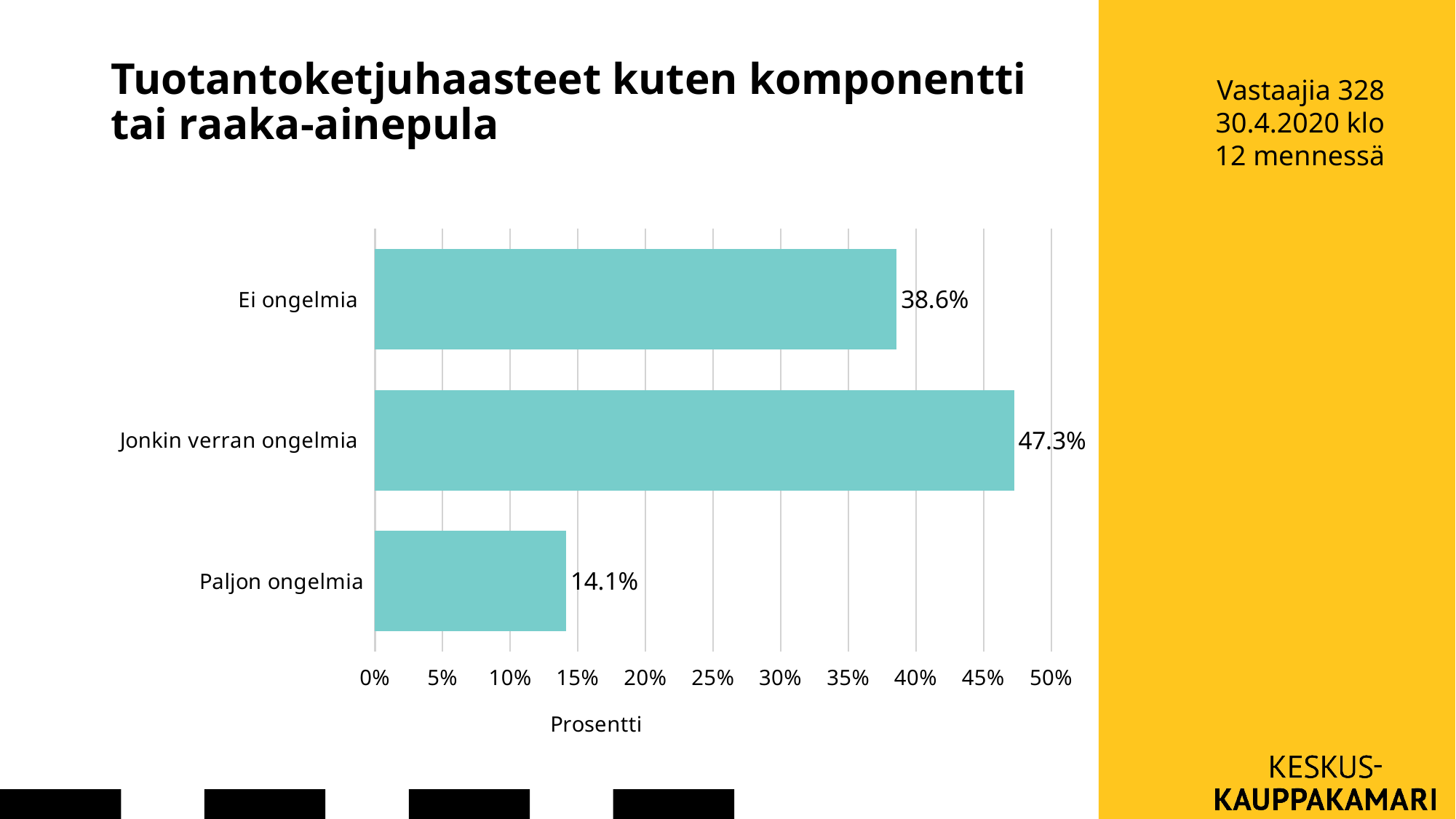
What is the difference between the values for "Jonkin verran ongelmia" and "Ei ongelmia"? 8.7% Which is larger, the value for "Ei ongelmia" or the value for "Paljon ongelmia"? Ei ongelmia Is the value for "Jonkin verran ongelmia" greater or less than 45%? greater What is the difference between the values for "Ei ongelmia" and "Paljon ongelmia"? 24.5% What is the label of the horizontal axis? Prosentti What is the value for "Jonkin verran ongelmia"? 47.3% What is the value for "Paljon ongelmia"? 14.1% How many categories are shown in the chart? 3 What kind of chart is shown on the slide? Bar chart What is the value for "Ei ongelmia"? 38.6% Which category has the highest value? Jonkin verran ongelmia Which category has the lowest value? Paljon ongelmia